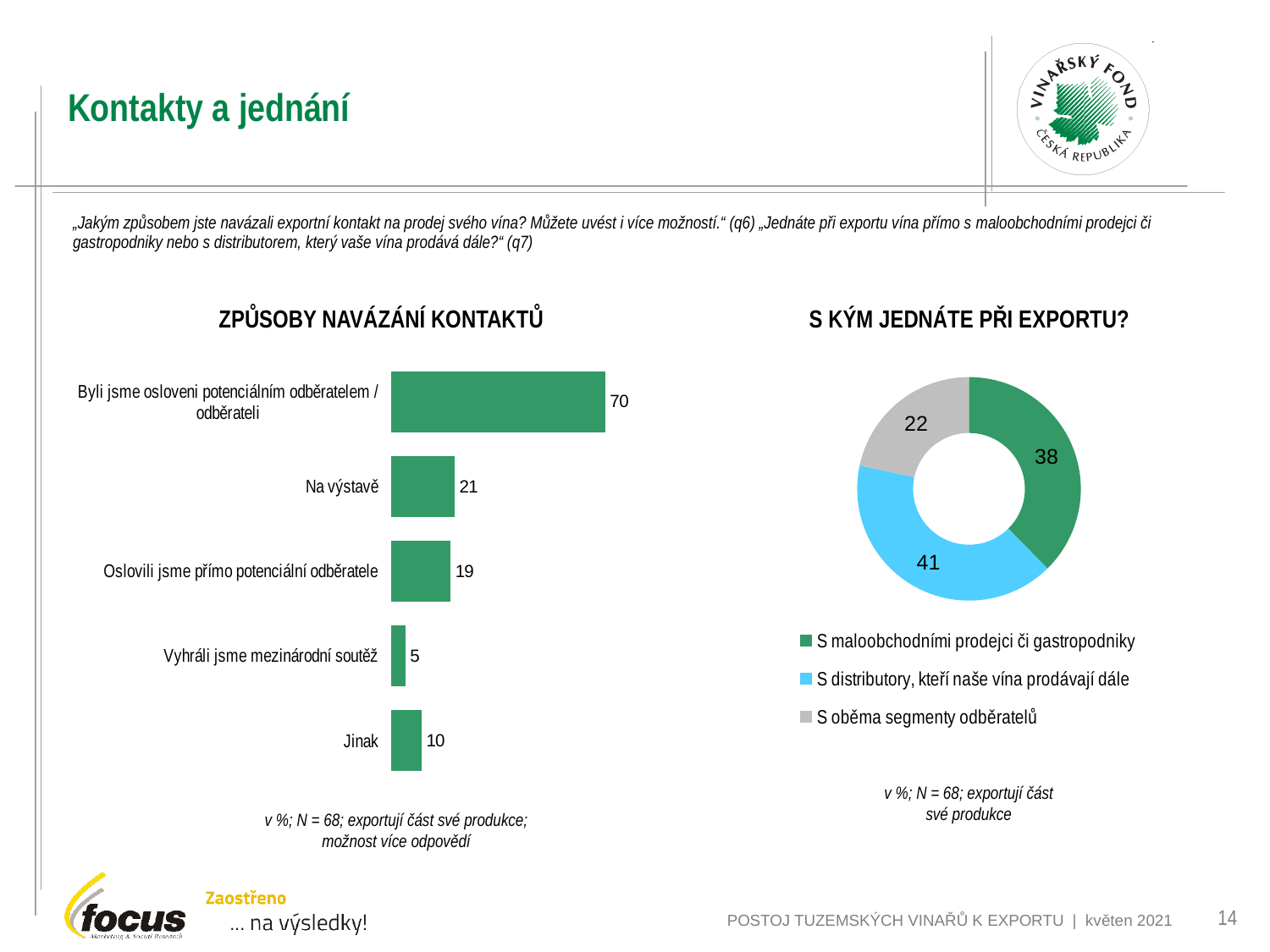
How many categories are shown in the 'ZPŮSOBY NAVÁZÁNÍ KONTAKTŮ' chart? 5 In the 'S KÝM JEDNÁTE PŘI EXPORTU?' chart, which segment has the smallest value? S oběma segmenty odběratelů In the 'ZPŮSOBY NAVÁZÁNÍ KONTAKTŮ' chart, which category has the highest value? Byli jsme osloveni potenciálním odběratelem / odběrateli In the 'ZPŮSOBY NAVÁZÁNÍ KONTAKTŮ' chart, what is the difference between the values for 'Byli jsme osloveni potenciálním odběratelem / odběrateli' and 'Na výstavě'? 49 In the 'S KÝM JEDNÁTE PŘI EXPORTU?' chart, what colour is the segment for 'S maloobchodními prodejci či gastropodniky'? Green What kind of chart is 'ZPŮSOBY NAVÁZÁNÍ KONTAKTŮ'? Bar chart What kind of chart is 'S KÝM JEDNÁTE PŘI EXPORTU?'? Doughnut chart In the 'ZPŮSOBY NAVÁZÁNÍ KONTAKTŮ' chart, which category has the lowest value? Vyhráli jsme mezinárodní soutěž How many entries does the legend of the 'S KÝM JEDNÁTE PŘI EXPORTU?' chart list? 3 In the 'S KÝM JEDNÁTE PŘI EXPORTU?' chart, what is the value for 'S distributory, kteří naše vína prodávají dále'? 41 In the 'ZPŮSOBY NAVÁZÁNÍ KONTAKTŮ' chart, what is the value for 'Na výstavě'? 21 In the 'ZPŮSOBY NAVÁZÁNÍ KONTAKTŮ' chart, which is larger: 'Jinak' or 'Vyhráli jsme mezinárodní soutěž'? Jinak